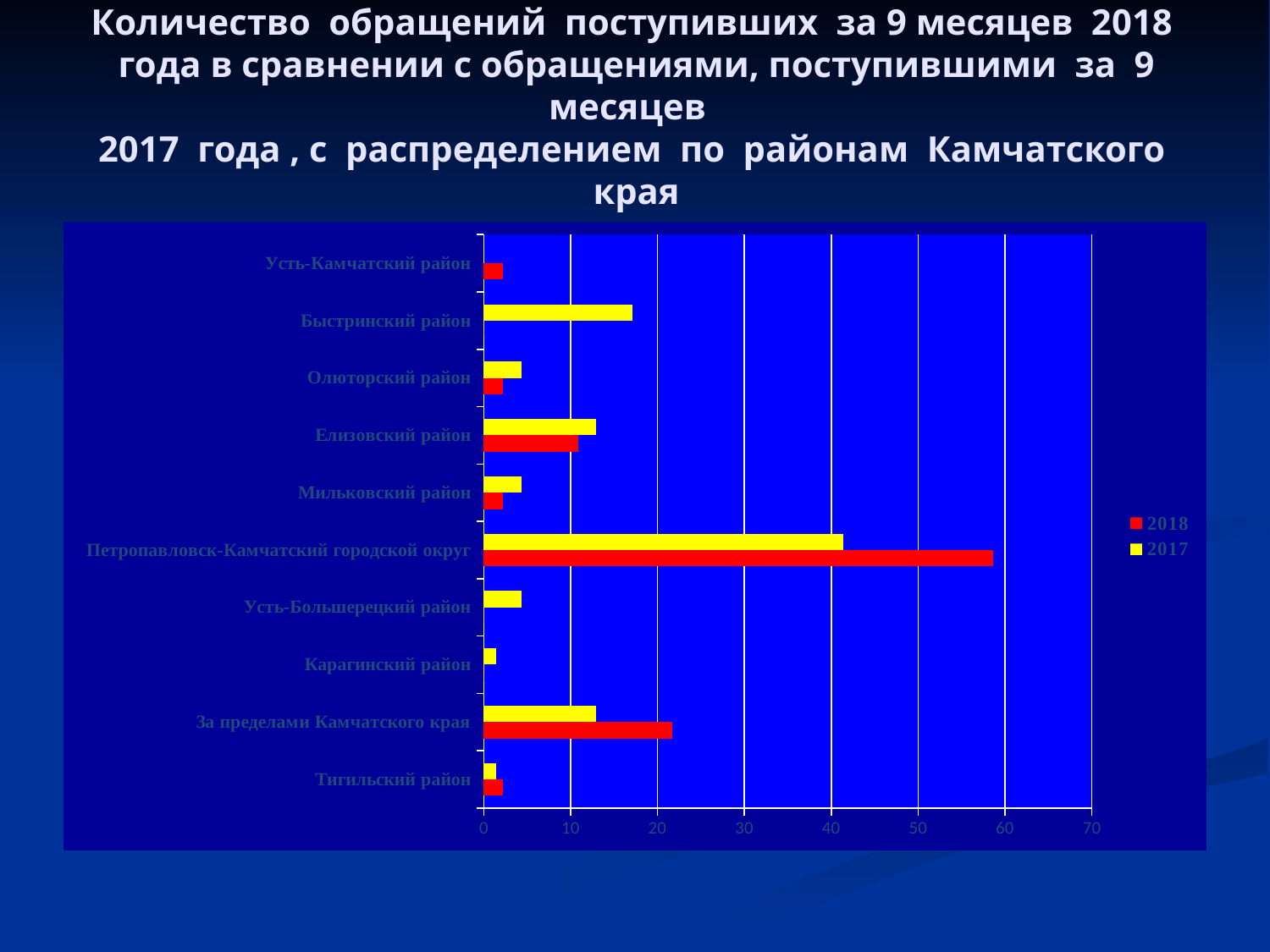
Which colour represents the 2017 series in the legend? yellow For Петропавловск-Камчатский городской округ, which year has the larger value, 2018 or 2017? 2018 Is the 2017 value for Петропавловск-Камчатский городской округ greater or less than 50? less Is the 2018 value for За пределами Камчатского края greater or less than 20? greater For За пределами Камчатского края, which year has the larger value, 2018 or 2017? 2018 How many districts (categories) are shown on the vertical axis? 10 Which category has the highest value for 2018? Петропавловск-Камчатский городской округ Is the 2017 value for Быстринский район greater or less than 10? greater How many series does the legend list? 2 What kind of chart is shown on the slide? bar chart Which category has the highest value for 2017? Петропавловск-Камчатский городской округ